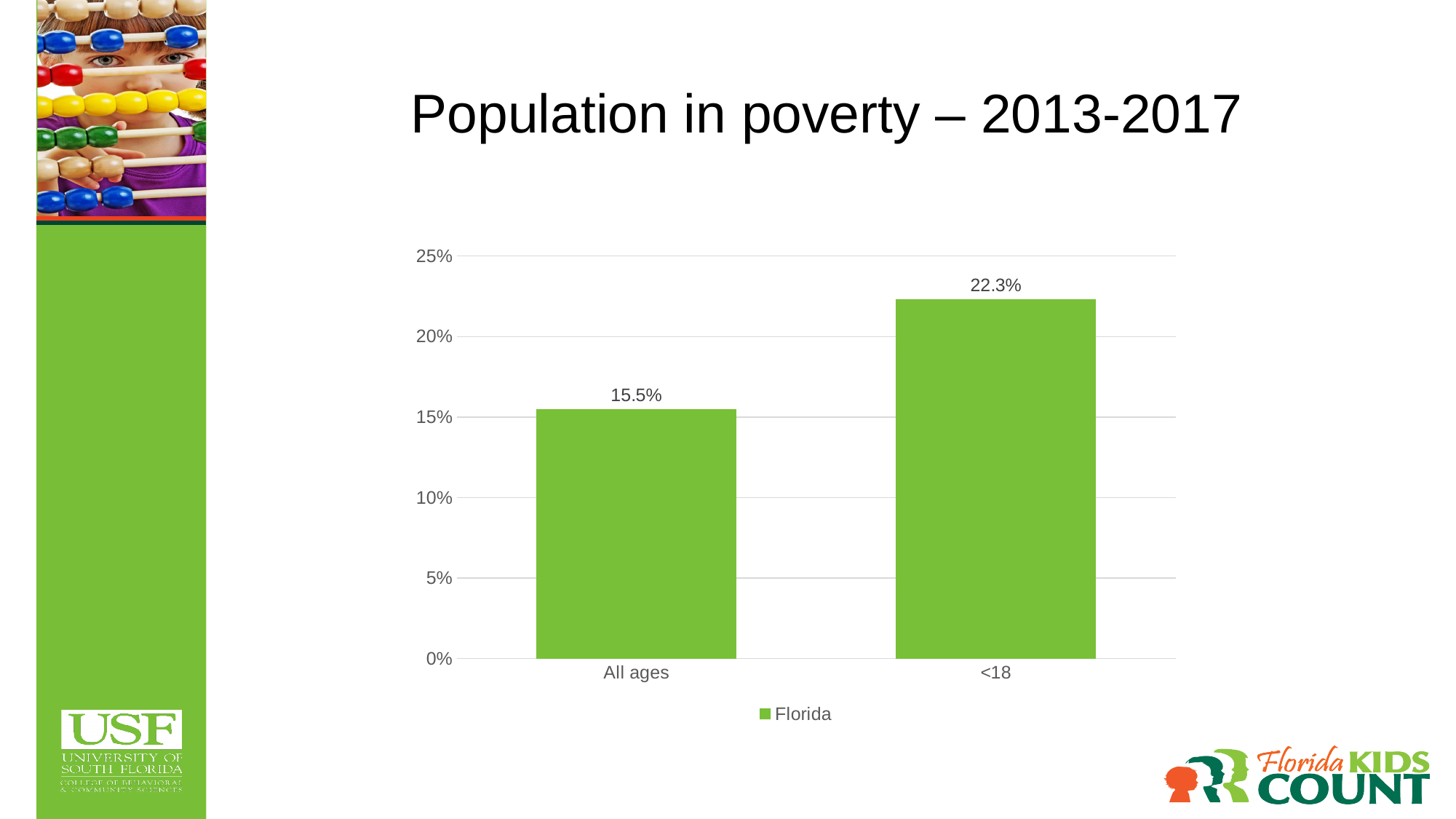
Is the poverty rate for <18 larger than the rate for All ages? Yes What is the poverty rate for the <18 category? 22.3% What kind of chart is shown on the slide? Bar chart What is the poverty rate for All ages? 15.5% Which category has the lower poverty rate? All ages What series name is shown in the legend? Florida Is the value for All ages greater or less than 20%? less Which category has the higher poverty rate? <18 What is the difference in percentage points between the <18 rate and the All ages rate? 6.8 Is the value for <18 greater or less than 20%? greater How many series does the legend list? 1 How many categories are shown on the x axis? 2